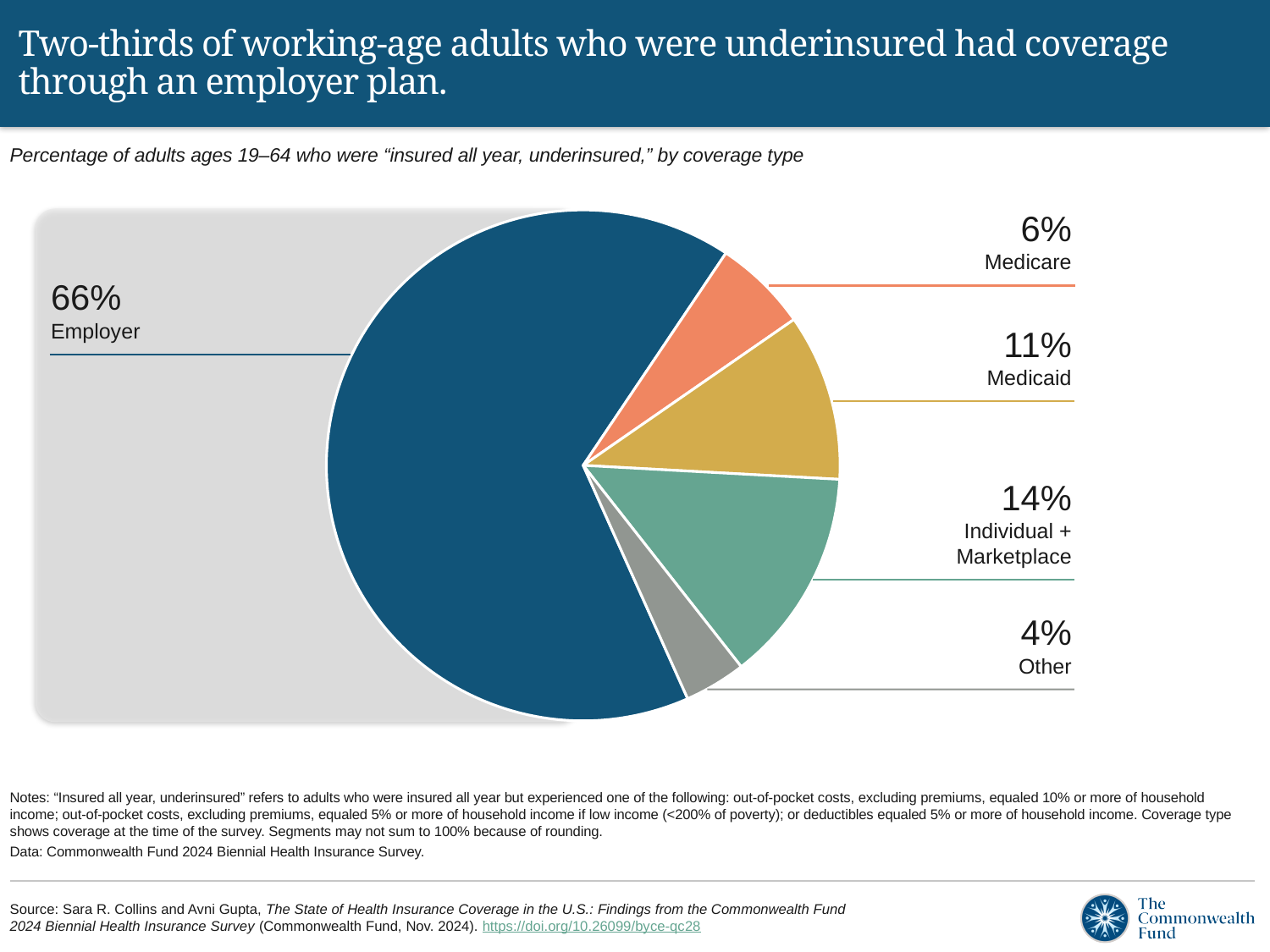
What kind of chart is shown on the slide? Pie chart How many coverage types are shown in the pie chart? 5 Which coverage type has the largest share of the pie? Employer What percentage of underinsured adults had coverage through an employer plan? 66% What percentage of underinsured adults had Medicare coverage? 6% What percentage of underinsured adults had Medicaid coverage? 11% Which is larger, the Medicaid slice or the Medicare slice? Medicaid What is the combined percentage of the Medicare and Other slices? 10% What percentage of underinsured adults had Individual + Marketplace coverage? 14% What is the difference in percentage points between the Employer and Individual + Marketplace slices? 52 What colour is the Employer slice of the pie? Dark blue Which coverage type has the smallest share of the pie? Other